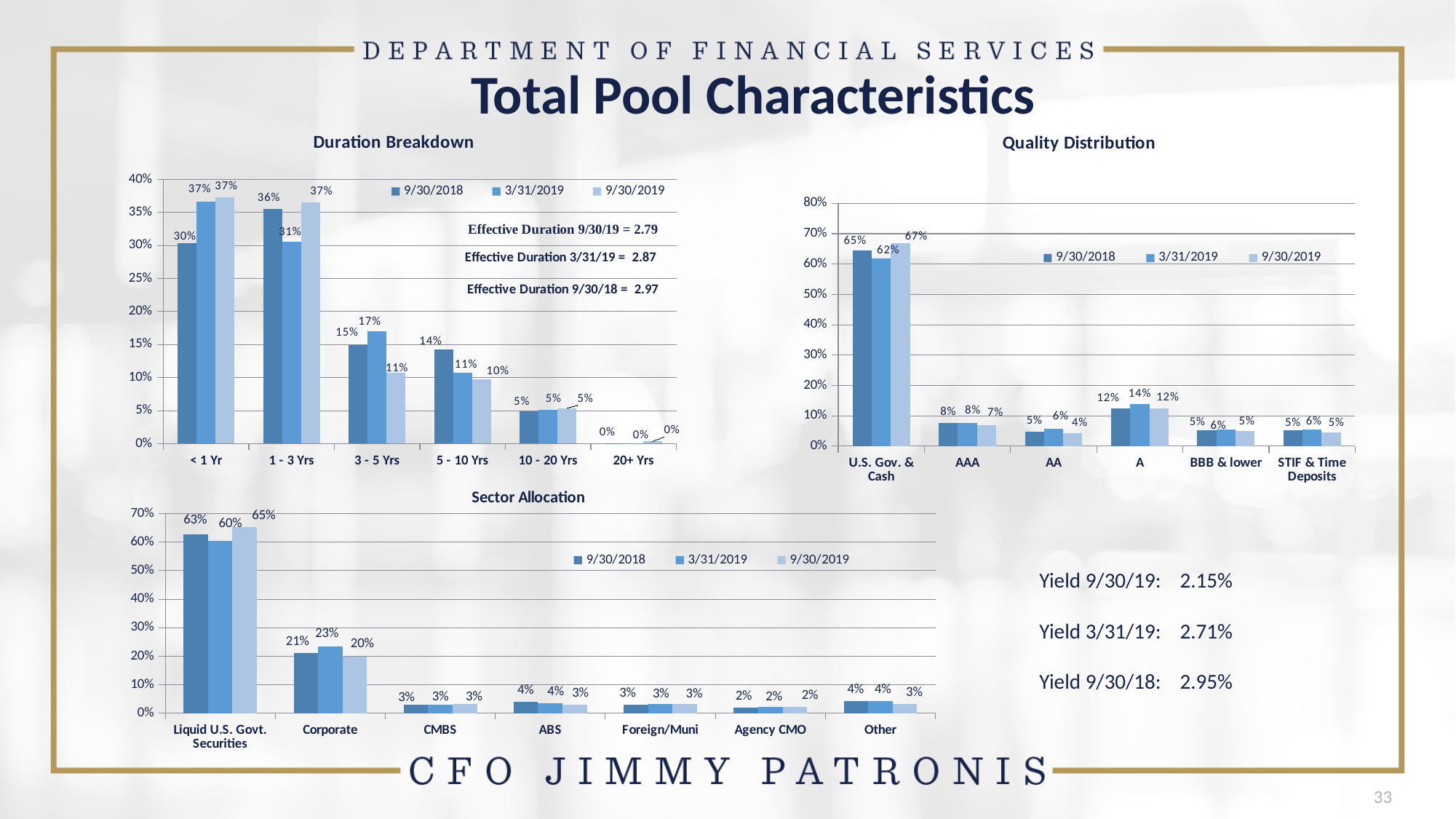
In the Sector Allocation chart, which is larger for Liquid U.S. Govt. Securities: the 9/30/2018 value or the 3/31/2019 value? 9/30/2018 In the Duration Breakdown chart, what is the value for 3 - 5 Yrs in the 3/31/2019 series? 17% In the Duration Breakdown chart, how many duration categories are shown on the x axis? 6 In the Sector Allocation chart, what is the value for Corporate in the 3/31/2019 series? 23% In the Quality Distribution chart, how many series does the legend list? 3 In the Quality Distribution chart, is the 9/30/2018 value for U.S. Gov. & Cash greater or less than 60%? greater In the Duration Breakdown chart, what is the value for 5 - 10 Yrs in the 9/30/2018 series? 14% What type of chart is the Sector Allocation chart? Bar chart In the Duration Breakdown chart, what is the difference between the 9/30/2019 and 9/30/2018 values for < 1 Yr? 7% In the Quality Distribution chart, which category has the highest value in the 9/30/2019 series? U.S. Gov. & Cash In the Sector Allocation chart, which category has the lowest values across all three series? Agency CMO In the Quality Distribution chart, what is the value for A in the 3/31/2019 series? 14%